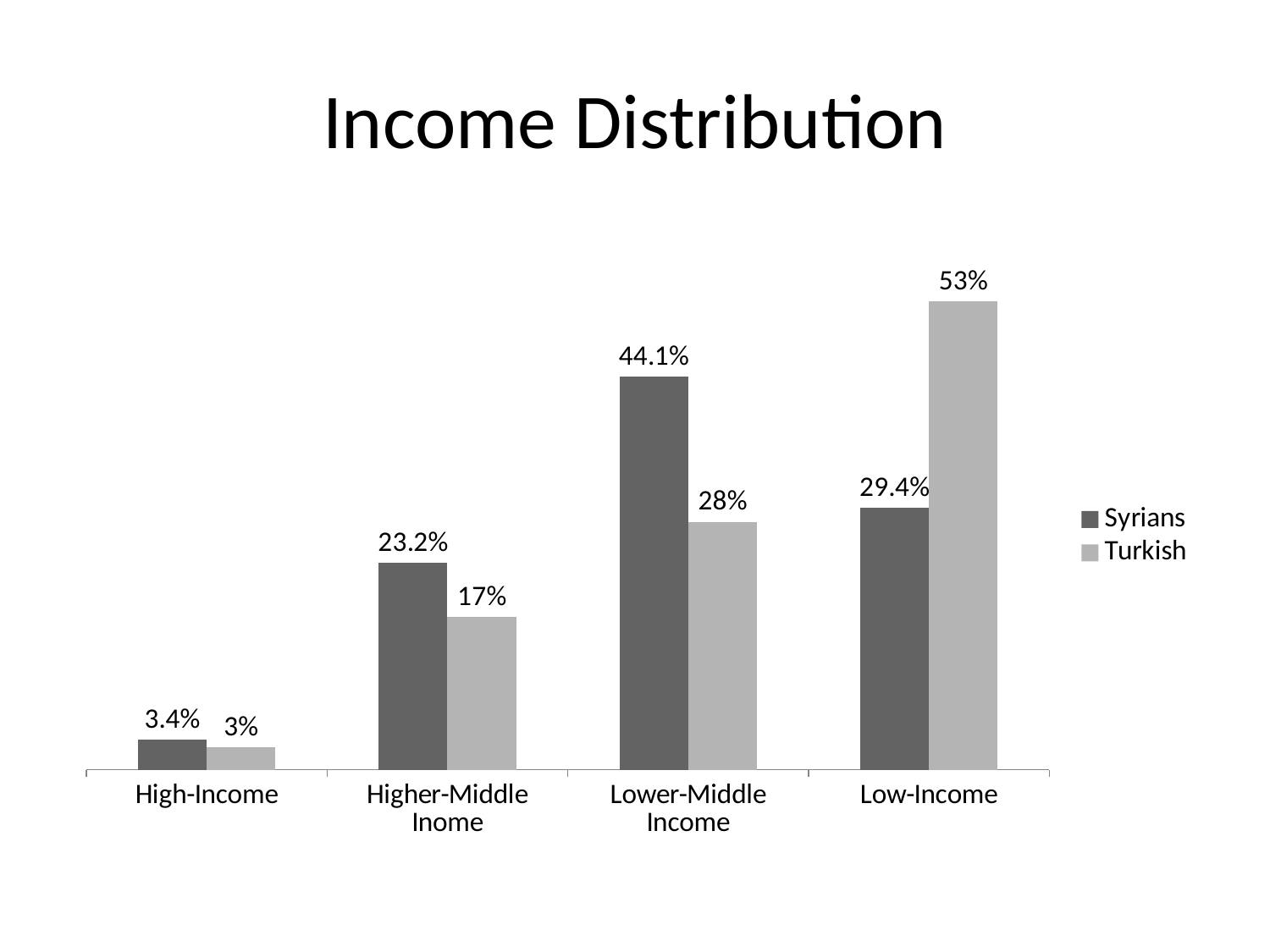
What is the value for Syrians in the Lower-Middle Income category? 44.1% What is the difference between the Syrians and Turkish values in the Low-Income category? 23.6% What is the value for Turkish in the Higher-Middle Inome category? 17% How many series does the legend list? 2 How many income categories are shown on the x axis? 4 What is the value for Turkish in the Low-Income category? 53% Which category has the highest value for the Turkish series? Low-Income Which category has the lowest value for the Syrians series? High-Income What is the value for Syrians in the High-Income category? 3.4% What is the title of the chart? Income Distribution In the Lower-Middle Income category, which series has the larger value, Syrians or Turkish? Syrians What kind of chart is shown on the slide? Bar chart